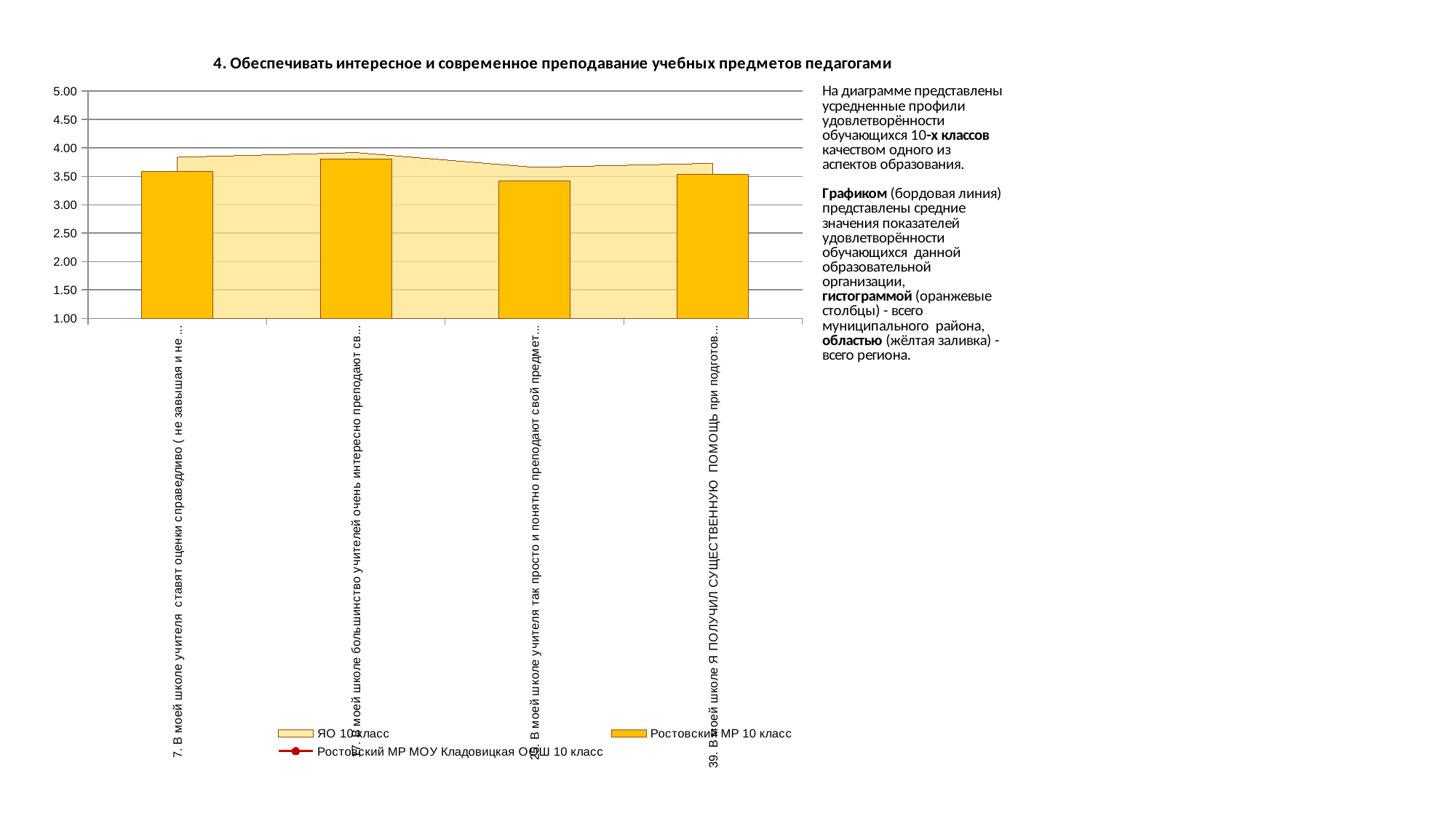
What kind of chart is used for the series 'Ростовский МР 10 класс'? bar chart Which series is shown with the yellow filled area? ЯО 10 класс Is the orange bar for category 7 greater or less than 3.00? greater Which category has the highest orange bar (Ростовский МР 10 класс)? 17. В моей школе большинство учителей очень интересно преподают св... What is the maximum value shown on the vertical axis? 5.00 How many series does the chart legend list? 3 Is the orange bar for category 39 greater or less than 4.00? less Which category has the lowest orange bar (Ростовский МР 10 класс)? 25. В моей школе учителя так просто и понятно преподают свой предмет... Is the orange bar for category 17 greater or less than 3.50? greater How many bars (categories) are plotted on the chart? 4